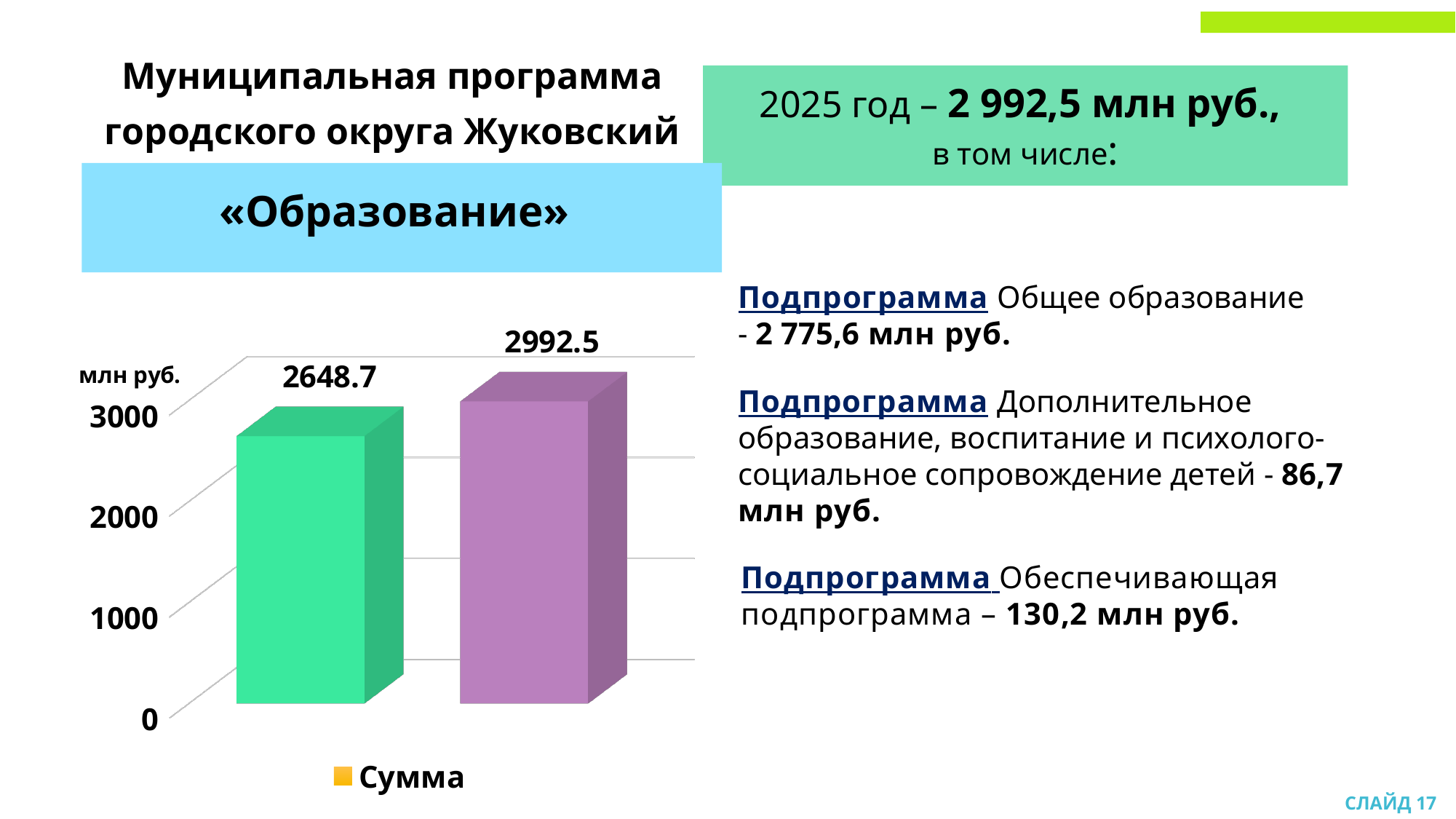
Which bar has the higher value, the left green bar or the right purple bar? the right purple bar What is the value shown on the right (purple) bar of the chart? 2992.5 How many bars are plotted in the chart? 2 Which bar has the lower value, the left green bar or the right purple bar? the left green bar What is the difference between the values of the right bar and the left bar? 343.8 What kind of chart is shown on the slide? bar chart Is the value of the left green bar greater or less than 3000? less What is the name of the series shown in the chart legend? Сумма How many series does the chart legend list? 1 Do the bar values rise or fall from left to right? rise What is the value shown on the left (green) bar of the chart? 2648.7 Is the value of the right purple bar greater or less than 2000? greater